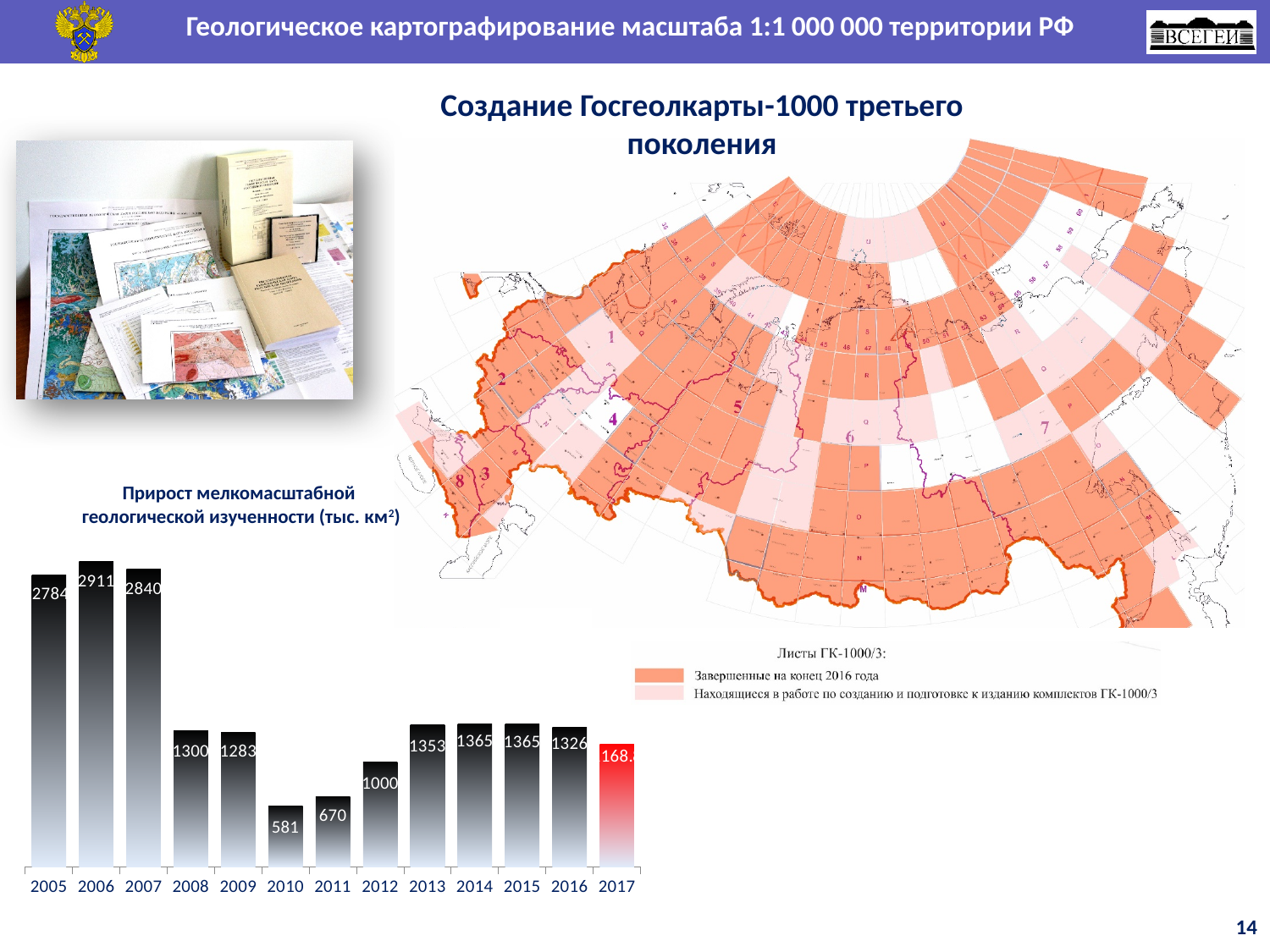
What is the value for 2005 in the bar chart? 2784 What is the value for 2010 in the bar chart? 581 How many years are shown on the x axis of the bar chart? 13 What is the value for 2016 in the bar chart? 1326 What is the difference between the values for 2011 and 2010 in the bar chart? 89 Which year has the highest value in the bar chart? 2006 What type of chart is shown at the bottom left of the slide? bar chart What is the value for 2012 in the bar chart? 1000 Which is larger in the bar chart, the value for 2008 or the value for 2009? 2008 Which year has the lowest value in the bar chart? 2010 What is the title of the bar chart? Прирост мелкомасштабной геологической изученности (тыс. км²) What is the difference between the values for 2006 and 2007 in the bar chart? 71